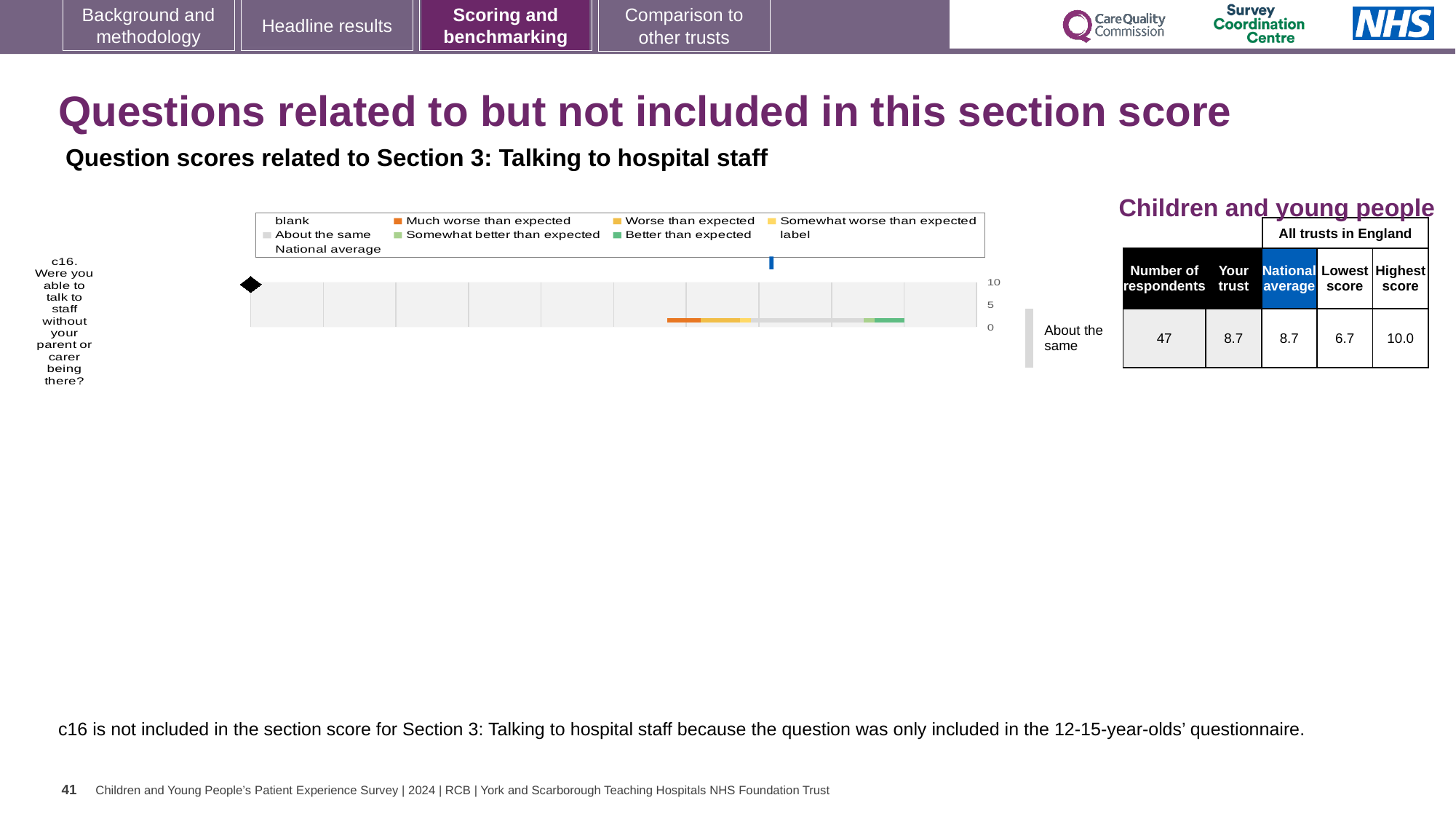
In the 'Children and young people' table, what is the 'Your trust' score for c16? 8.7 How many entries does the chart legend list? 9 In the 'Children and young people' table, what is the difference between the highest score and the lowest score for c16? 3.3 How many questions (categories) are plotted on the chart? 1 In the 'Children and young people' table, what is the highest score across all trusts in England for c16? 10.0 What is the highest tick value shown on the chart's axis? 10 In the 'Children and young people' table, what is the national average for c16? 8.7 Which question is plotted on the chart? c16. Were you able to talk to staff without your parent or carer being there? In the 'Children and young people' table, what is the lowest score across all trusts in England for c16? 6.7 In the 'Children and young people' table, what is the number of respondents for c16? 47 What colour does the legend use for 'Much worse than expected'? orange What kind of chart is shown on the slide for question c16? bar chart